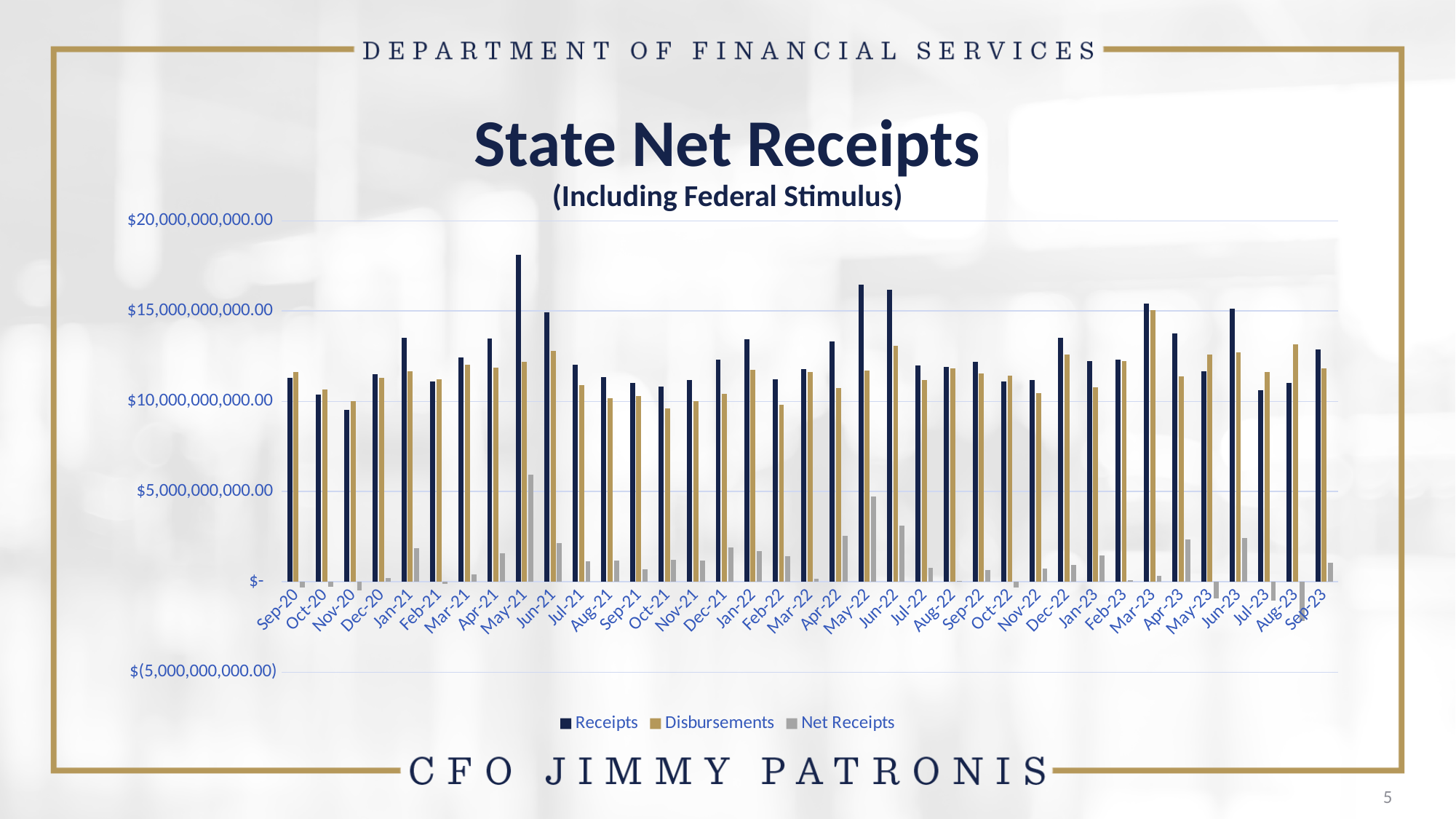
Is the Receipts value for Nov-20 greater or less than $10,000,000,000.00? less What kind of chart is shown on the slide? bar chart Which month has the highest Net Receipts value? May-21 Which is larger, the Receipts value for May-21 or for Jun-21? May-21 Which month has the highest Disbursements value? Mar-23 Is the Net Receipts value for May-21 greater or less than $5,000,000,000.00? greater Which month has the lowest Receipts value? Nov-20 Is the Receipts value for May-21 greater or less than $15,000,000,000.00? greater How many series does the legend list? 3 Which month has the highest Receipts value? May-21 How many months are plotted along the x axis? 37 What is the subtitle shown under the chart title 'State Net Receipts'? (Including Federal Stimulus)